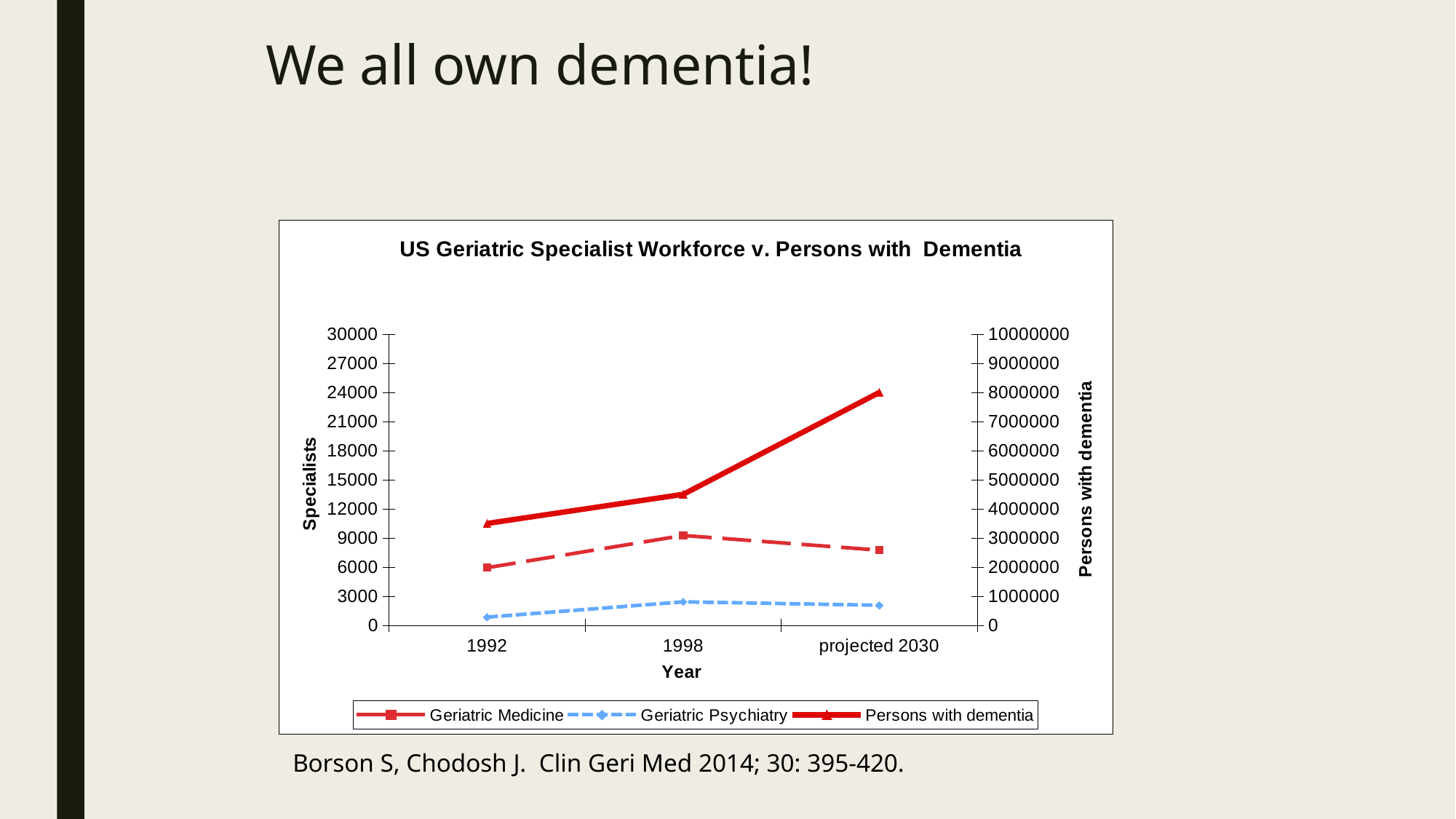
Which is larger in projected 2030, the Geriatric Medicine value or the Geriatric Psychiatry value? Geriatric Medicine Which series is plotted against the right-hand axis labelled 'Persons with dementia'? Persons with dementia Does the Persons with dementia line rise or fall from 1992 to projected 2030? rise How many points along the x axis (Year) does the chart show? 3 Is the Persons with dementia value for projected 2030 greater or less than 7000000? greater In which year is the Geriatric Psychiatry series lowest? 1992 What is the title of the chart? US Geriatric Specialist Workforce v. Persons with Dementia What kind of chart is shown on the slide? line chart In which year is the Geriatric Medicine series highest? 1998 How many series does the legend list? 3